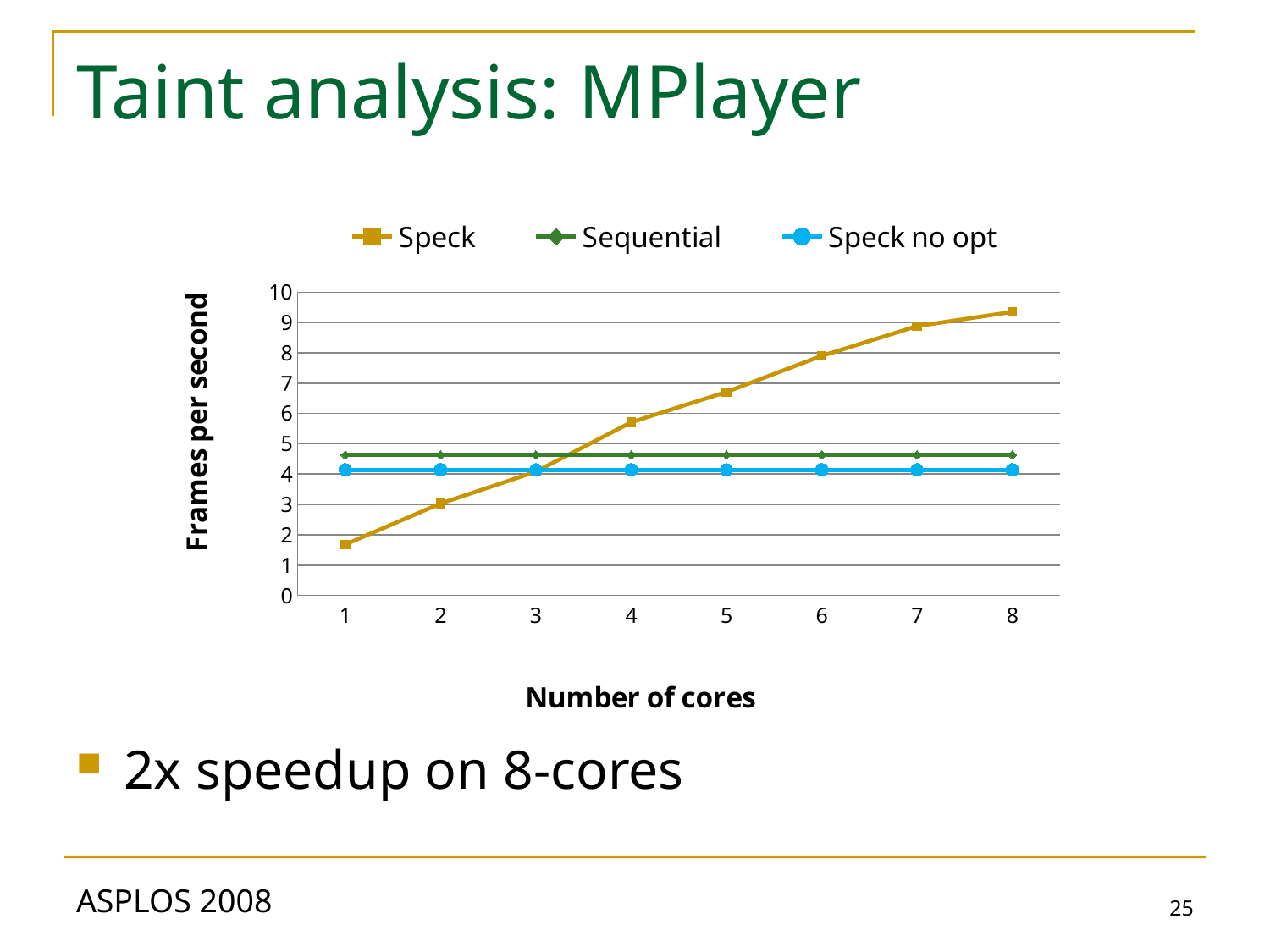
Is the Speck value at 1 core greater or less than 2 frames per second? less How many series does the legend list? 3 At 1 core, which is larger: Speck or Speck no opt? Speck no opt Does the Sequential series rise, fall, or stay flat as the number of cores increases? stays flat Is the Speck value at 4 cores greater or less than 5 frames per second? greater Is the Speck value at 8 cores greater or less than 9 frames per second? greater What kind of chart is shown on the slide? line chart What is the label of the y axis? Frames per second Does the Speck series rise or fall as the number of cores increases? rises How many core counts are plotted along the x axis? 8 At 8 cores, which is larger: Speck or Sequential? Speck Which series has the highest value at 8 cores? Speck